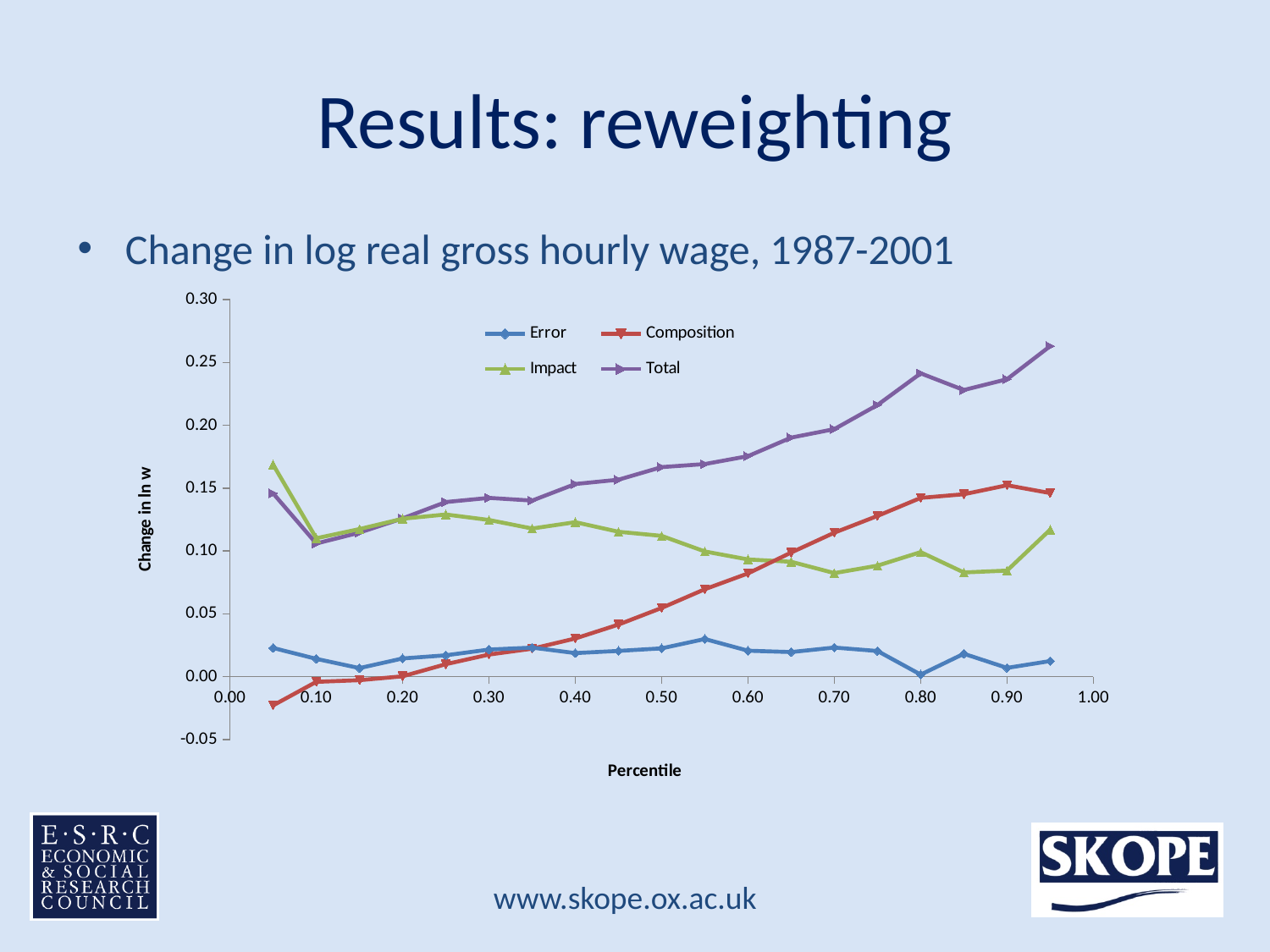
Which series has the lowest value at percentile 0.95? Error Is the value of the Composition series at percentile 0.05 greater or less than 0.00? less Does the Composition series rise or fall as the percentile increases from 0.05 to 0.90? rises How many series does the chart's legend list? 4 At percentile 0.05, which series has the larger value, Impact or Total? Impact Which series has the highest value at percentile 0.95? Total At percentile 0.90, which series has the larger value, Composition or Impact? Composition What are the four series named in the chart's legend? Error, Composition, Impact, Total Does the Total series rise or fall as the percentile increases from 0.10 to 0.95? rises What is the title of the chart's horizontal axis? Percentile Is the value of the Total series at percentile 0.95 greater or less than 0.25? greater What kind of chart is shown on the slide? line chart